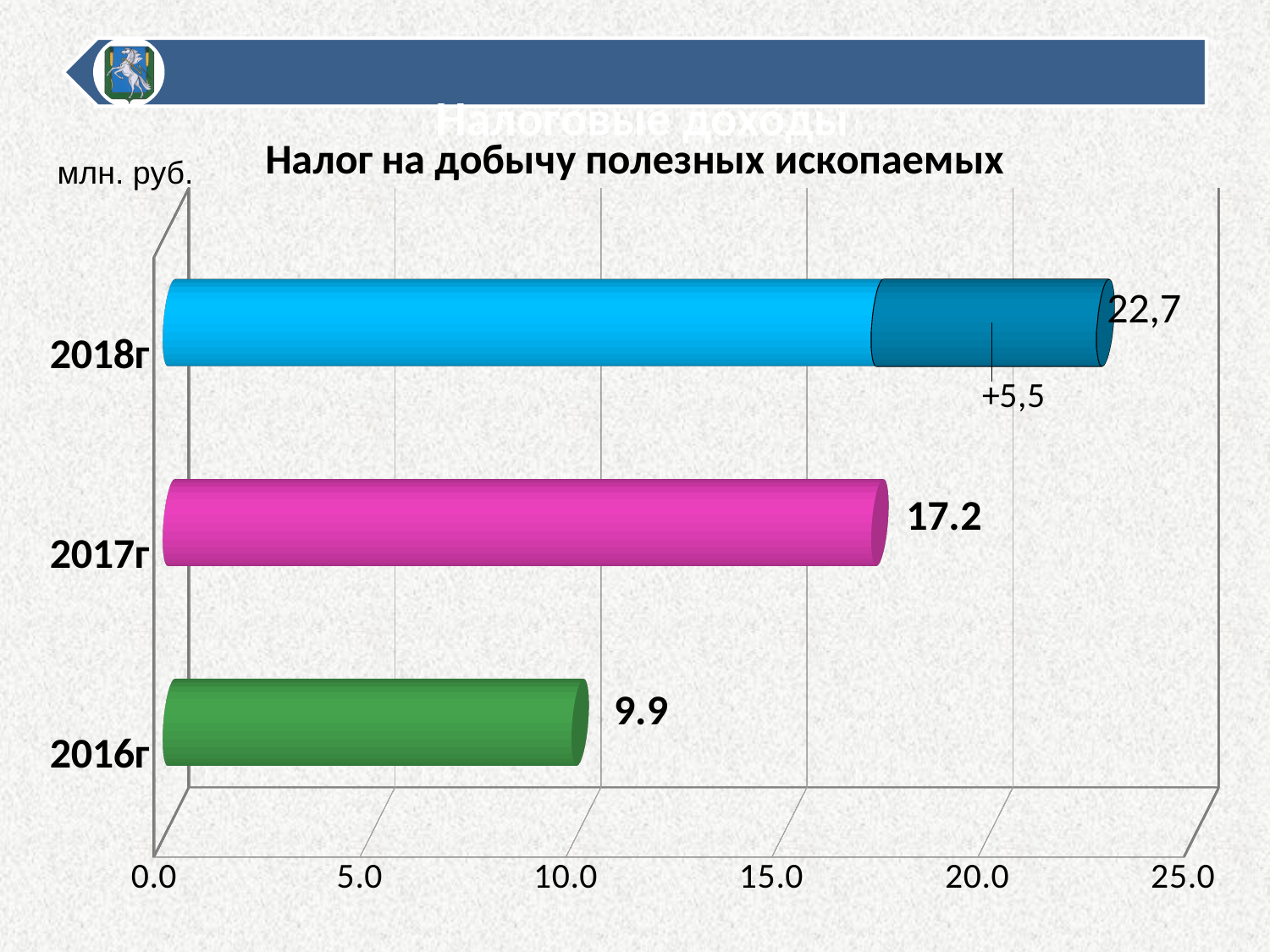
Which is larger, the value for 2017г or the value for 2016г? 2017г What is the value for 2018г? 22,7 What is the increase from 2017г to 2018г as labelled on the chart? +5,5 What is the difference between the values for 2017г and 2016г? 7.3 Which year has the lowest value? 2016г What is the value for 2016г? 9.9 How many years are shown on the chart? 3 What kind of chart is shown? bar chart Which year has the highest value? 2018г What is the value for 2017г? 17.2 Is the value for 2018г greater or less than 20.0? greater What unit is shown for the chart values? млн. руб.